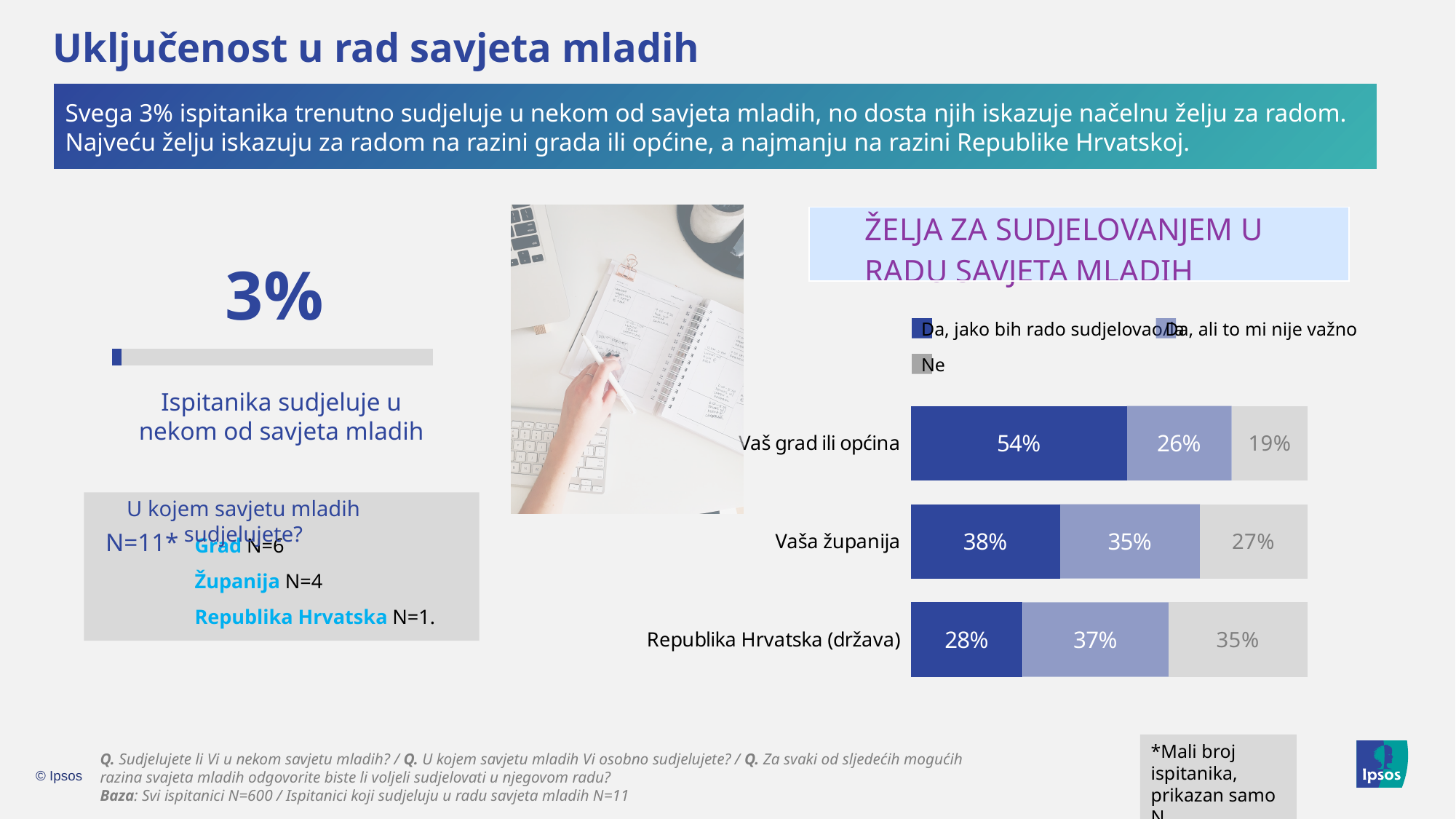
In the stacked bar chart, which category has the highest "Da, jako bih rado sudjelovao/la" value? Vaš grad ili općina In the stacked bar chart, what is the "Ne" value for "Republika Hrvatska (država)"? 35% In the stacked bar chart, what is the "Da, ali to mi nije važno" value for "Vaša županija"? 35% How many series does the legend of the stacked bar chart list? 3 In the stacked bar chart, which is larger: the "Ne" value for "Vaša županija" or for "Republika Hrvatska (država)"? Republika Hrvatska (država) In the stacked bar chart, which category has the lowest "Ne" value? Vaš grad ili općina What type of chart is used to show the desire to participate in youth councils? Stacked bar chart What is the title of the stacked bar chart? ŽELJA ZA SUDJELOVANJEM U RADU SAVJETA MLADIH In the stacked bar chart, what is the difference between the "Da, jako bih rado sudjelovao/la" values for "Vaš grad ili općina" and "Republika Hrvatska (država)"? 26 percentage points In the stacked bar chart, what percentage of respondents answered "Da, jako bih rado sudjelovao/la" for "Vaš grad ili općina"? 54% In the stacked bar chart, what is the total of the three segments for "Vaša županija"? 100% How many categories are shown in the stacked bar chart? 3